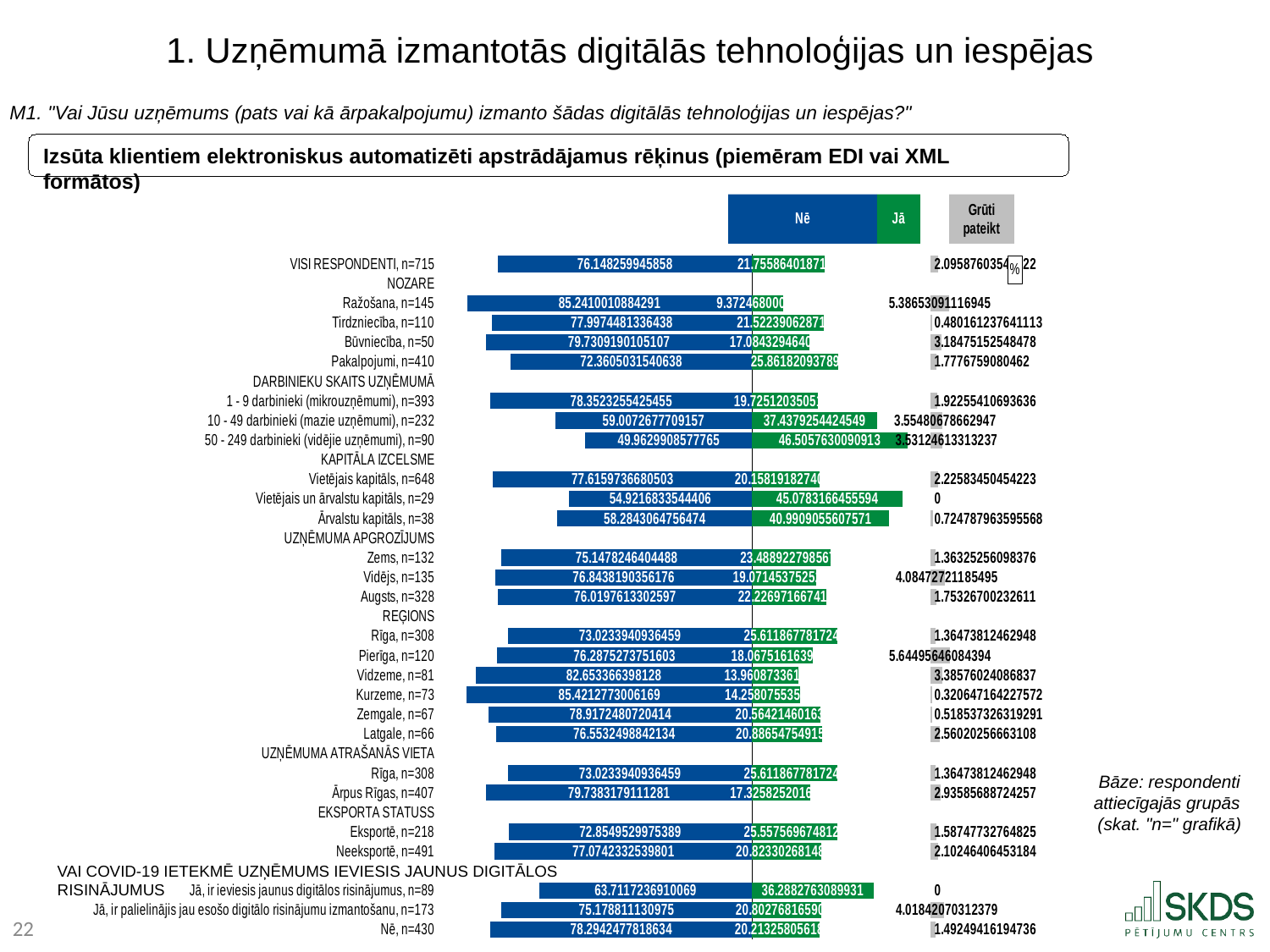
What is the Nē value for Kurzeme, n=73? 85.4212773006169 How many series does the legend list? 3 Which is larger, the Nē value for Rīga, n=308 or for Ārpus Rīgas, n=407? Ārpus Rīgas, n=407 Which category has the lowest Nē value? 50 - 249 darbinieki (vidējie uzņēmumi), n=90 How many categories are listed under the REĢIONS group? 6 What kind of chart is shown on the slide? Stacked bar chart What is the difference between the Nē and Jā values for Vietējais un ārvalstu kapitāls, n=29? 9.8433667088812 Which category has the highest Jā value? 50 - 249 darbinieki (vidējie uzņēmumi), n=90 What colour represents the Jā series in the legend? Green What is the Grūti pateikt value for Pierīga, n=120? 5.64495646084394 What is the value of the Nē series for Pakalpojumi, n=410? 72.3605031540638 What is the value of the Jā series for 10 - 49 darbinieki (mazie uzņēmumi), n=232? 37.4379254424549